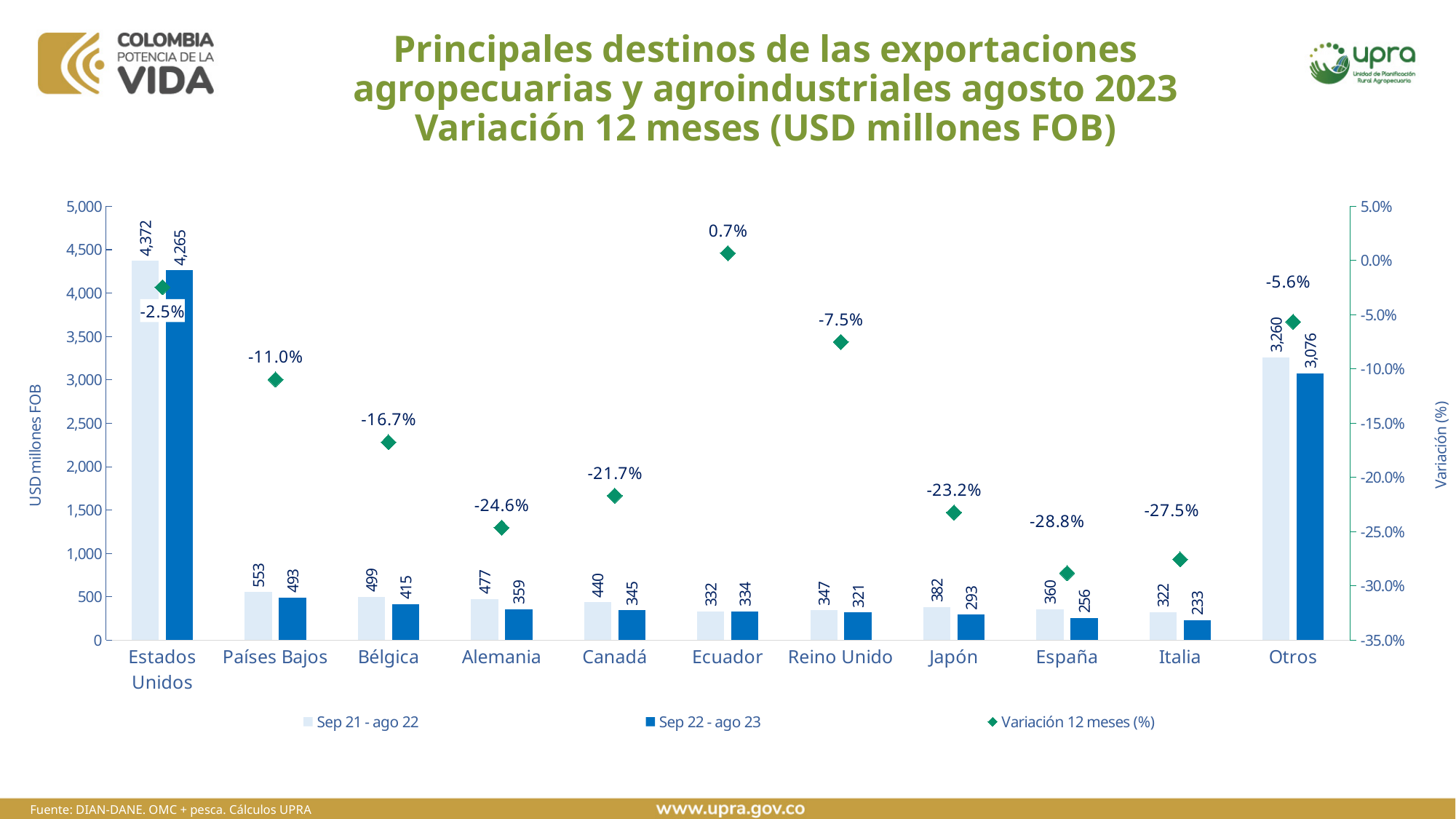
What is the value for Estados Unidos in the Sep 22 - ago 23 series? 4,265 Is the Sep 22 - ago 23 value for Otros greater or less than 3,000? greater What is the label of the left vertical axis? USD millones FOB How many categories are shown on the x axis? 11 What kind of chart is used for the Sep 21 - ago 22 and Sep 22 - ago 23 series? Bar chart Which named country (excluding Otros) has the highest value in the Sep 22 - ago 23 series? Estados Unidos What is the Variación 12 meses (%) value for Ecuador? 0.7% What is the value for Países Bajos in the Sep 21 - ago 22 series? 553 How many series does the legend list? 3 What is the difference between the Sep 21 - ago 22 and Sep 22 - ago 23 values for Bélgica? 84 Which category has the lowest Variación 12 meses (%) value? España Which is larger for Ecuador: the Sep 21 - ago 22 value or the Sep 22 - ago 23 value? Sep 22 - ago 23